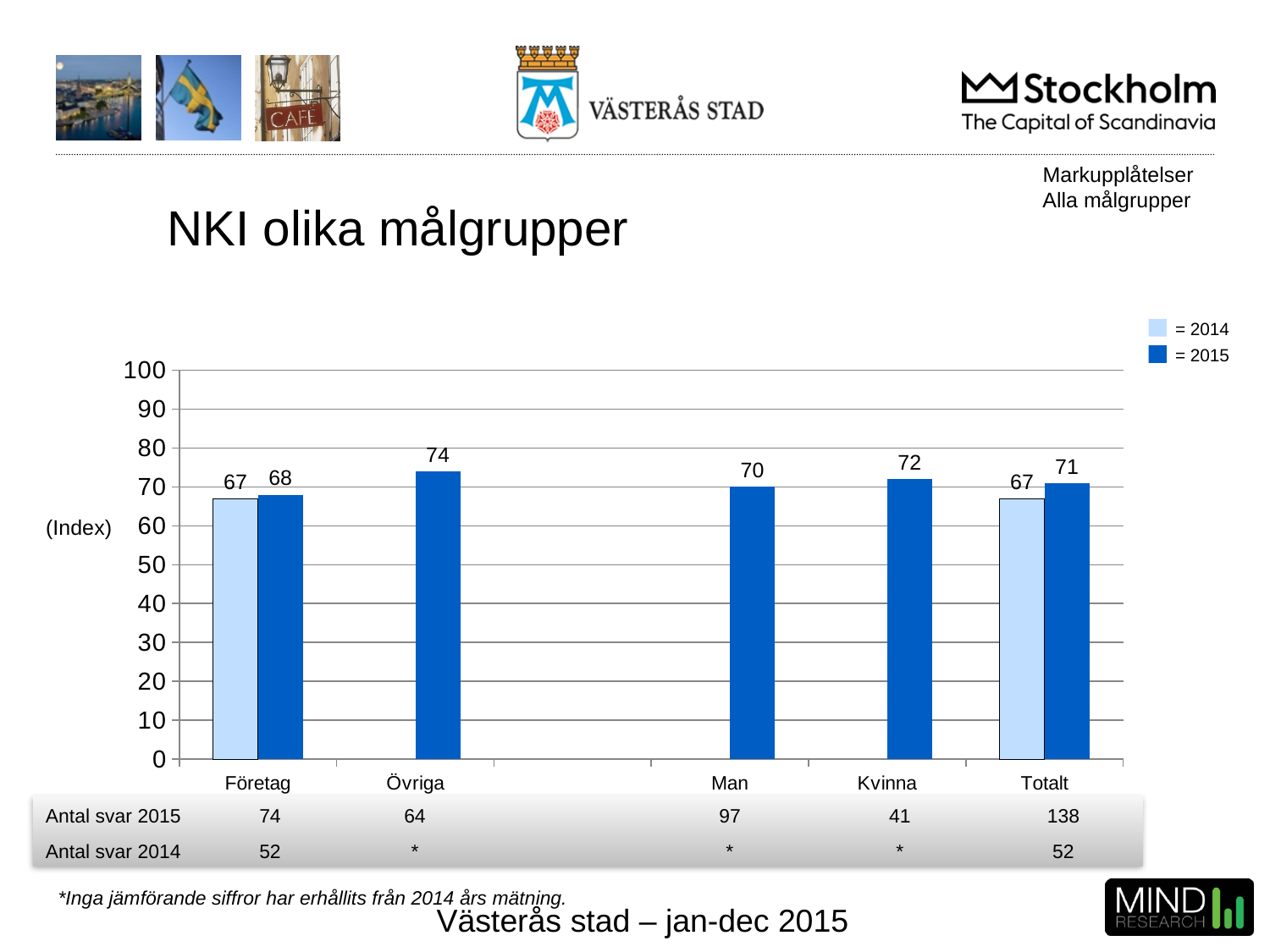
Is the 2015 NKI value for Övriga greater or less than 70? greater Which category has the highest 2015 NKI value? Övriga How many series does the legend list? 2 Which is larger, the 2015 NKI value for Man or for Kvinna? Kvinna Which categories have a 2014 bar in the chart? Företag and Totalt How many categories are shown on the x axis of the chart? 5 What is the difference between the 2015 and 2014 NKI values for Totalt? 4 What is the 2015 NKI value for Kvinna? 72 What kind of chart is shown on the slide? Bar chart Which category has the lowest 2015 NKI value? Företag What is the 2014 NKI value for Totalt? 67 What is the 2015 NKI value for Företag? 68